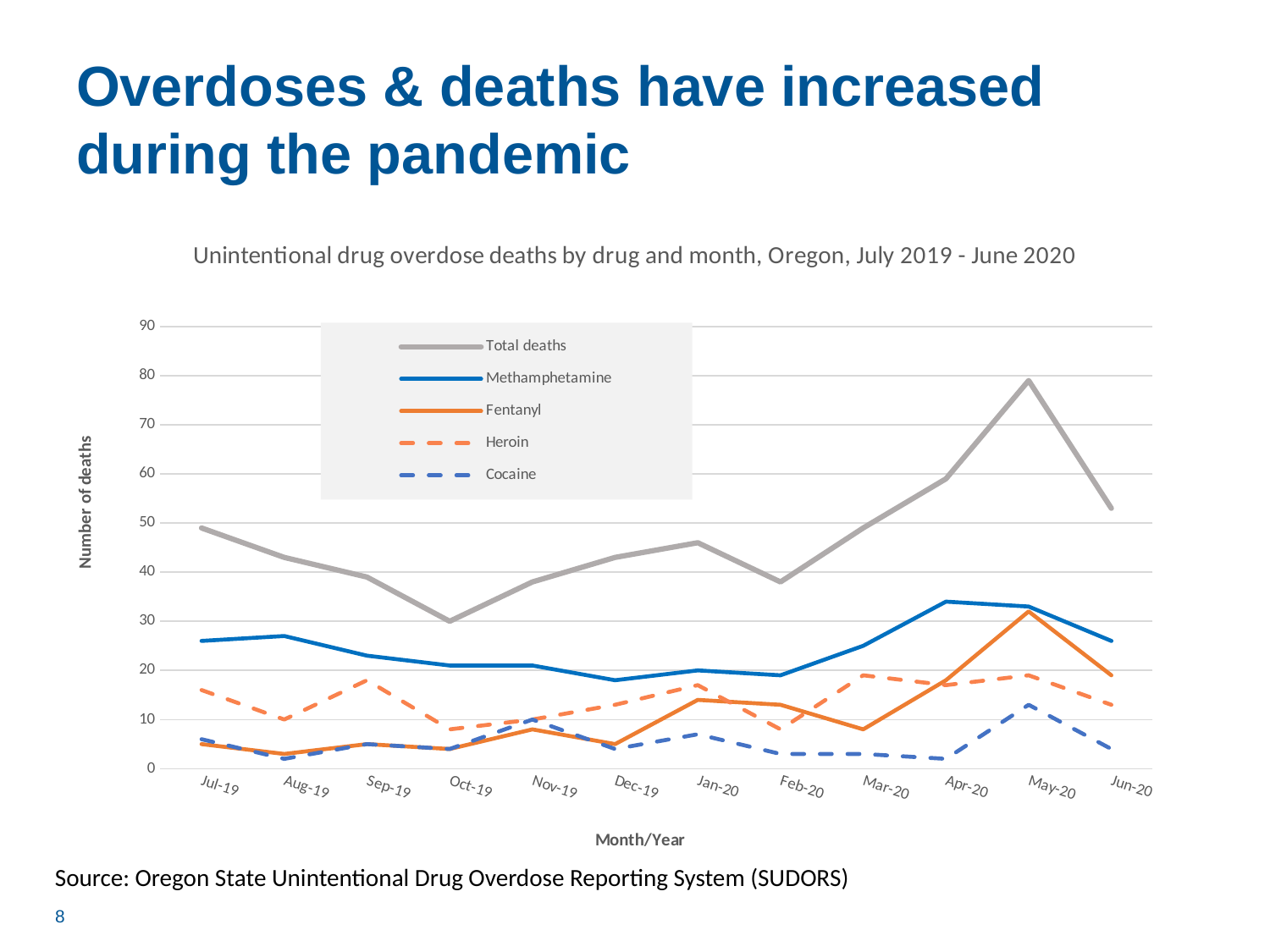
Is the value for Methamphetamine in Jul-19 greater or less than 20? greater How many months are plotted along the x axis? 12 What kind of chart is shown on the slide? line chart In which month do Total deaths reach their highest value? May-20 Do Total deaths rise or fall from Feb-20 to May-20? rise Is the value for Fentanyl in Jul-19 greater or less than 10? less In May-20, which is higher: Fentanyl or Heroin? Fentanyl What is the title of the chart? Unintentional drug overdose deaths by drug and month, Oregon, July 2019 - June 2020 Is the value for Total deaths in May-20 greater or less than 70? greater In which month are Total deaths at their lowest? Oct-19 How many series does the legend list? 5 In which month does the Fentanyl line reach its highest value? May-20